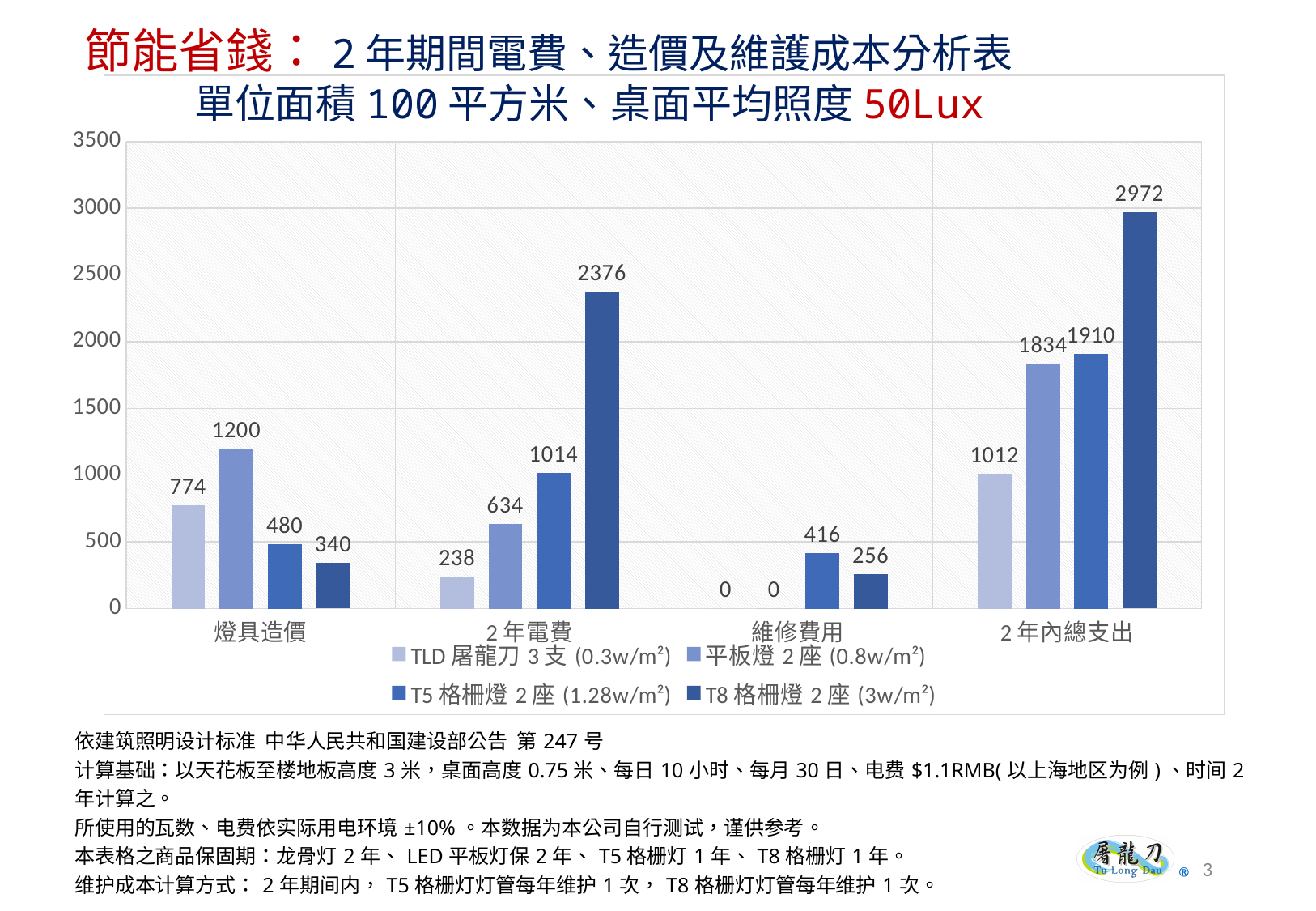
Which series has the highest 2年內總支出? T8 格柵燈 2座 (3w/m²) How many categories are shown on the x axis? 4 What is the difference between the 2年內總支出 of T8 格柵燈 2座 (3w/m²) and TLD 屠龍刀 3支 (0.3w/m²)? 1960 What is the 燈具造價 value for 平板燈 2座 (0.8w/m²)? 1200 What is the 維修費用 value for T5 格柵燈 2座 (1.28w/m²)? 416 What is the 2年電費 value for T8 格柵燈 2座 (3w/m²)? 2376 What is the 維修費用 value for 平板燈 2座 (0.8w/m²)? 0 Which is larger: the 2年電費 of T5 格柵燈 2座 (1.28w/m²) or of 平板燈 2座 (0.8w/m²)? T5 格柵燈 2座 (1.28w/m²) How many series does the legend list? 4 Which series has the lowest 燈具造價? T8 格柵燈 2座 (3w/m²) What kind of chart is shown on the slide? Bar chart What is the 2年內總支出 value for TLD 屠龍刀 3支 (0.3w/m²)? 1012